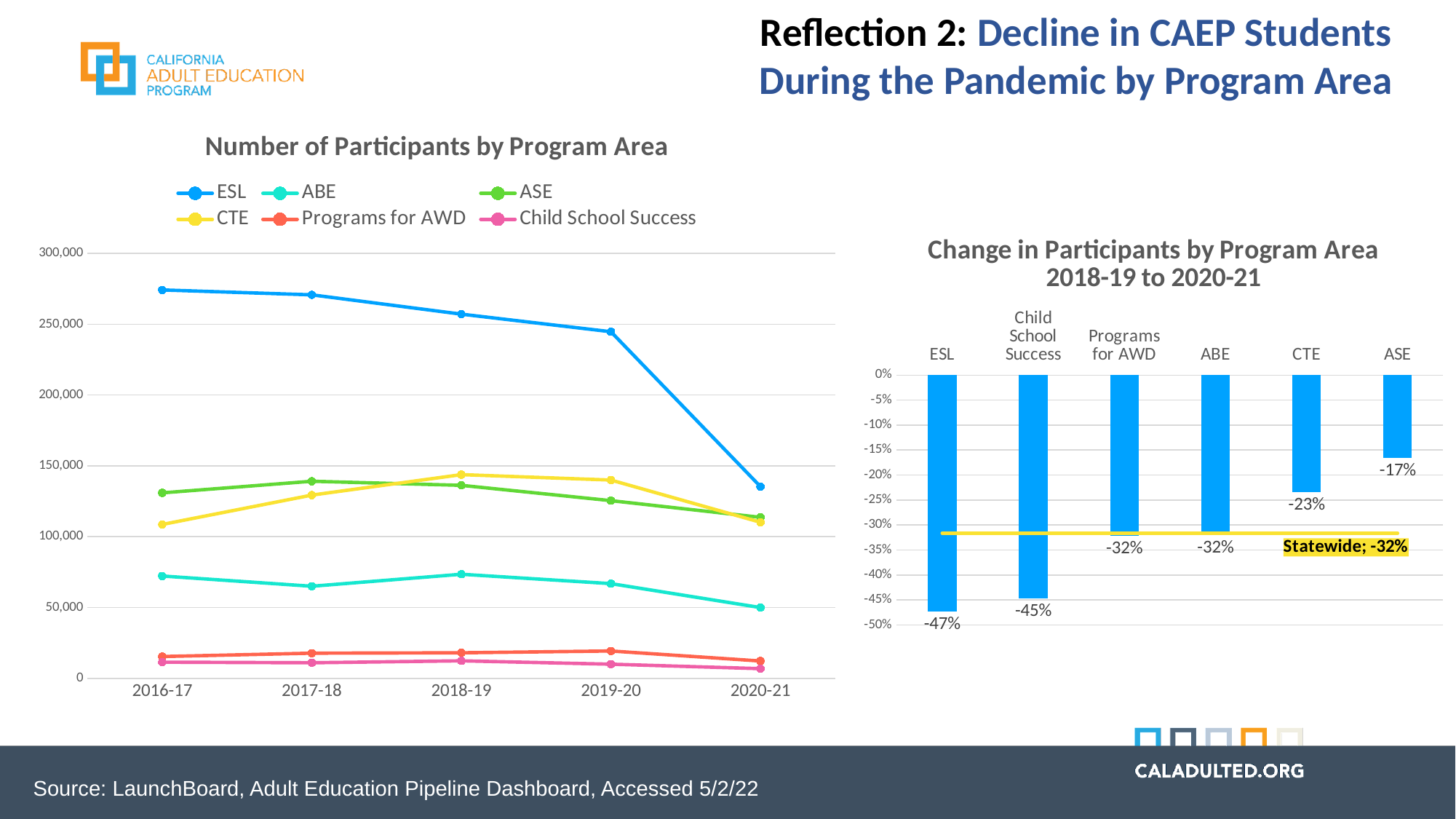
In the 'Number of Participants by Program Area' chart, is the ESL value for 2016-17 greater or less than 250,000? greater How many program areas are shown in the 'Change in Participants by Program Area 2018-19 to 2020-21' chart? 6 In the 'Change in Participants by Program Area 2018-19 to 2020-21' chart, what is the value for Child School Success? -45% What kind of chart is 'Number of Participants by Program Area'? Line chart In the 'Change in Participants by Program Area 2018-19 to 2020-21' chart, what is the value for ESL? -47% How many series does the legend of the 'Number of Participants by Program Area' chart list? 6 In the 'Change in Participants by Program Area 2018-19 to 2020-21' chart, which declined more, CTE or ABE? ABE In the 'Change in Participants by Program Area 2018-19 to 2020-21' chart, how many percentage points larger is the decline for ESL than for ASE? 30 percentage points In the 'Number of Participants by Program Area' chart, does the ESL line rise or fall from 2016-17 to 2020-21? Fall In the 'Change in Participants by Program Area 2018-19 to 2020-21' chart, which program area has the largest percentage decline? ESL In the 'Change in Participants by Program Area 2018-19 to 2020-21' chart, which program area has the smallest percentage decline? ASE In the 'Change in Participants by Program Area 2018-19 to 2020-21' chart, what is the value for ASE? -17%